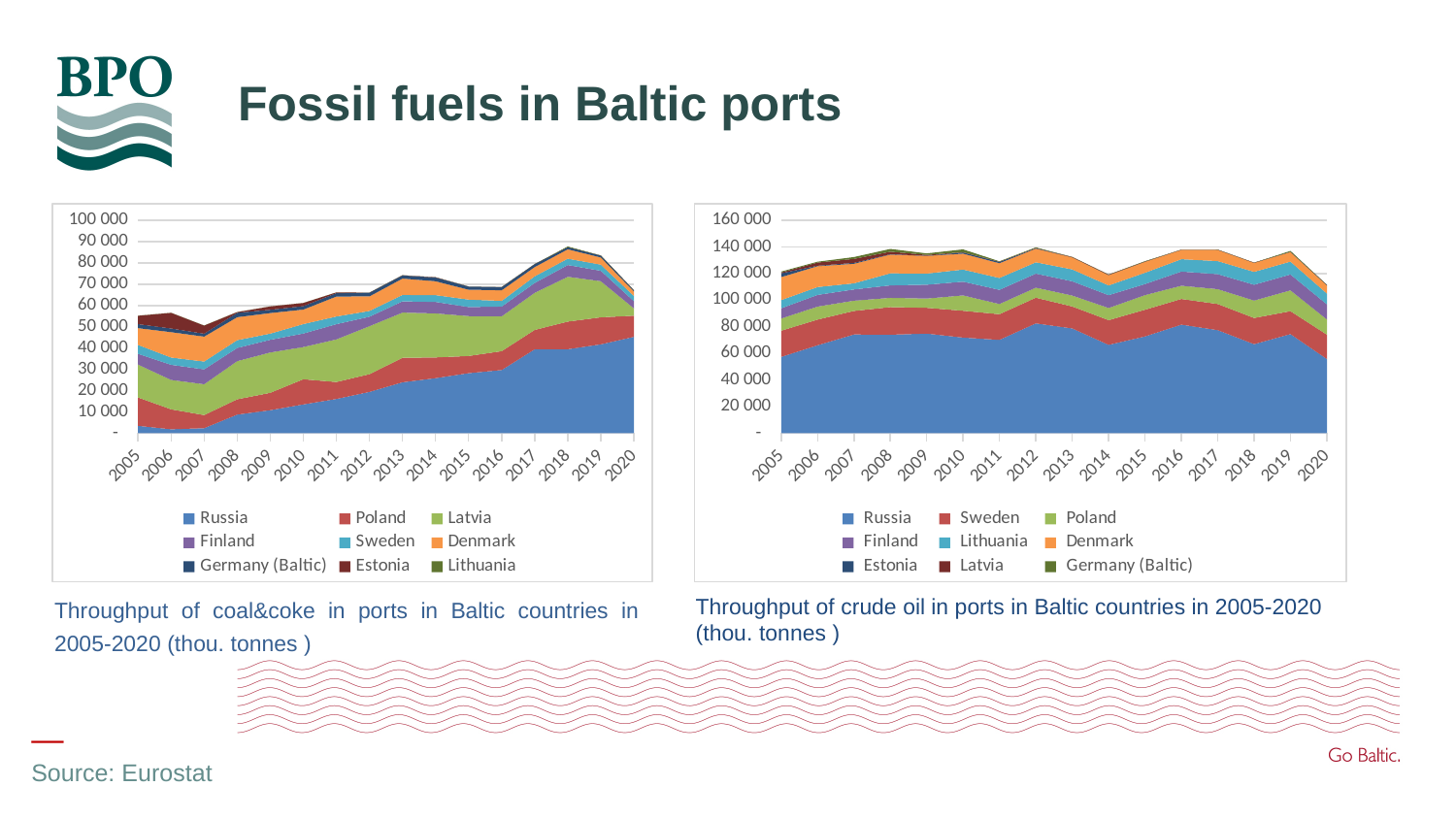
How many years are shown on the x axis of the left chart (throughput of coal&coke)? 16 In the left chart (throughput of coal&coke), is the total throughput in 2005 greater or less than 60 000? less In the right chart (throughput of crude oil), does the total throughput rise or fall from 2017 to 2020? fall How many series does the legend of the right chart (throughput of crude oil) list? 9 What unit is used for the values in both charts, according to the captions? thou. tonnes In the left chart (throughput of coal&coke), is the total throughput in 2018 greater or less than 80 000? greater What kind of chart is the left chart (throughput of coal&coke)? stacked area chart In the right chart (throughput of crude oil), is the total throughput in 2012 greater or less than 120 000? greater In the left chart (throughput of coal&coke), does the Russia series overall rise or fall from 2005 to 2018? rise Which series is listed first in the legend of the right chart (throughput of crude oil)? Russia